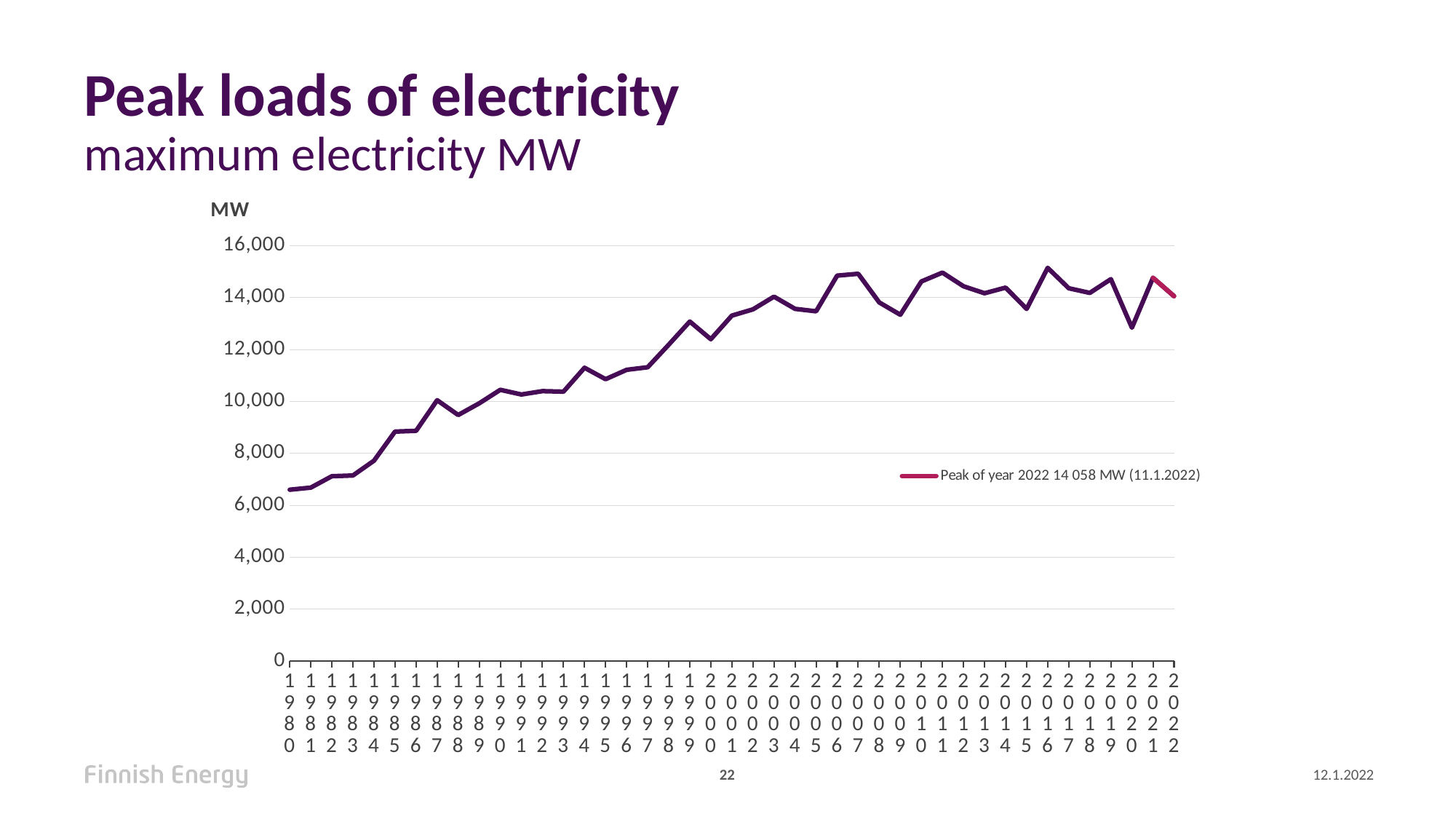
Is the peak load for 2016 greater or less than 14,000 MW? greater Is the peak load for 2020 greater or less than 14,000 MW? less Is the peak load for 1995 greater or less than 12,000 MW? less Which year has the lowest peak load in the chart? 1980 On what date did the 2022 peak load occur, according to the legend? 11.1.2022 What kind of chart is shown on the slide? line chart What unit is shown on the y axis of the chart? MW What was the peak load of electricity in 2022 according to the legend? 14 058 MW How many years are plotted on the x axis of the chart? 43 Overall, do peak loads rise or fall from 1980 to 2022? rise Which year has the larger peak load, 2020 or 2021? 2021